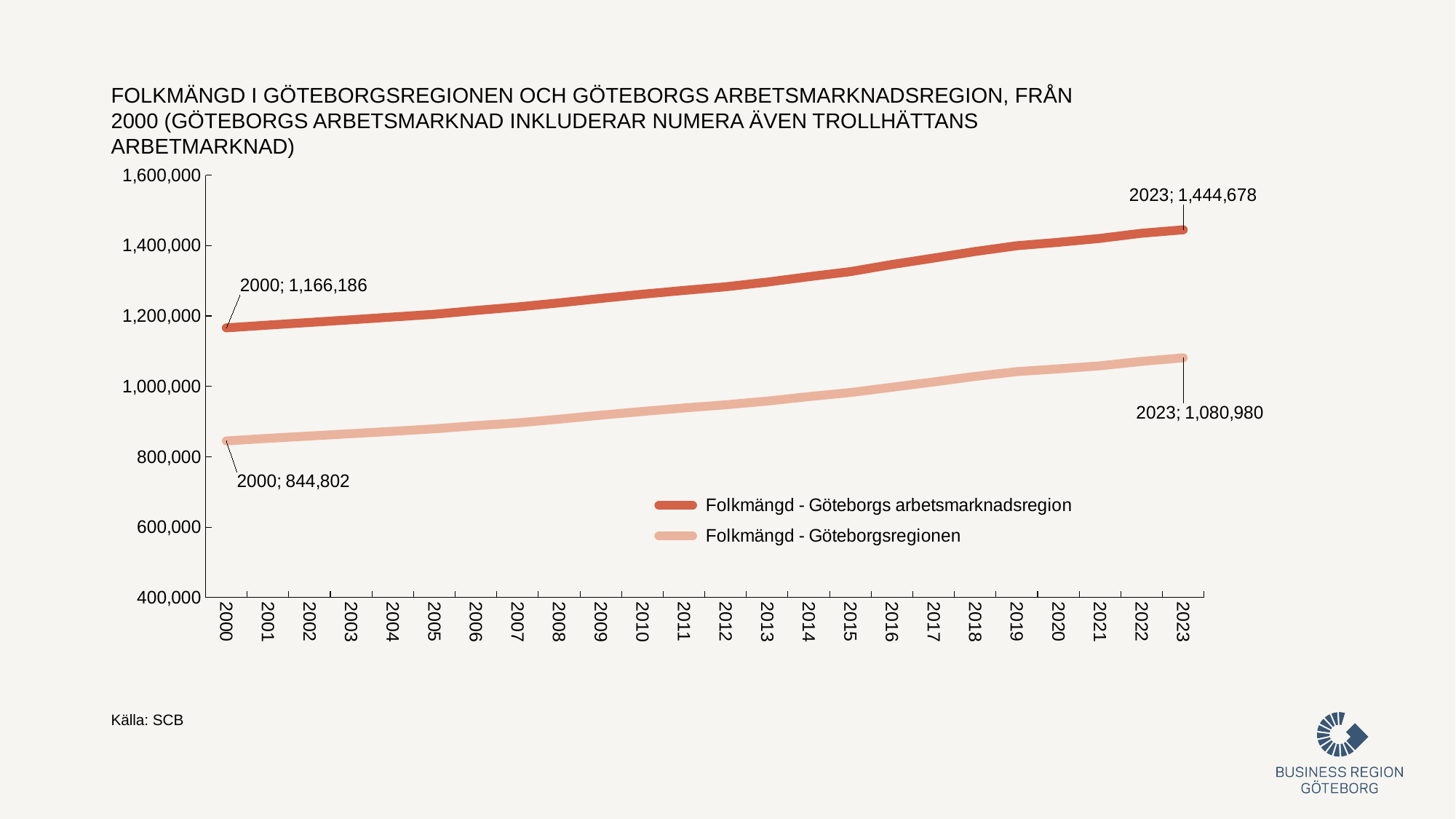
What type of chart is shown on the slide? Line chart Which series has the higher value in 2023, Göteborgs arbetsmarknadsregion or Göteborgsregionen? Göteborgs arbetsmarknadsregion What was the population of Göteborgs arbetsmarknadsregion in 2000? 1,166,186 What was the population of Göteborgsregionen in 2023? 1,080,980 How many series does the legend list? 2 How many years are shown on the x axis? 24 Is the value for Göteborgsregionen in 2010 greater or less than 1,000,000? less What was the population of Göteborgs arbetsmarknadsregion in 2023? 1,444,678 By how much did the population of Göteborgsregionen grow between 2000 and 2023? 236,178 What is the difference between the 2023 populations of Göteborgs arbetsmarknadsregion and Göteborgsregionen? 363,698 What was the population of Göteborgsregionen in 2000? 844,802 By how much did the population of Göteborgs arbetsmarknadsregion grow between 2000 and 2023? 278,492